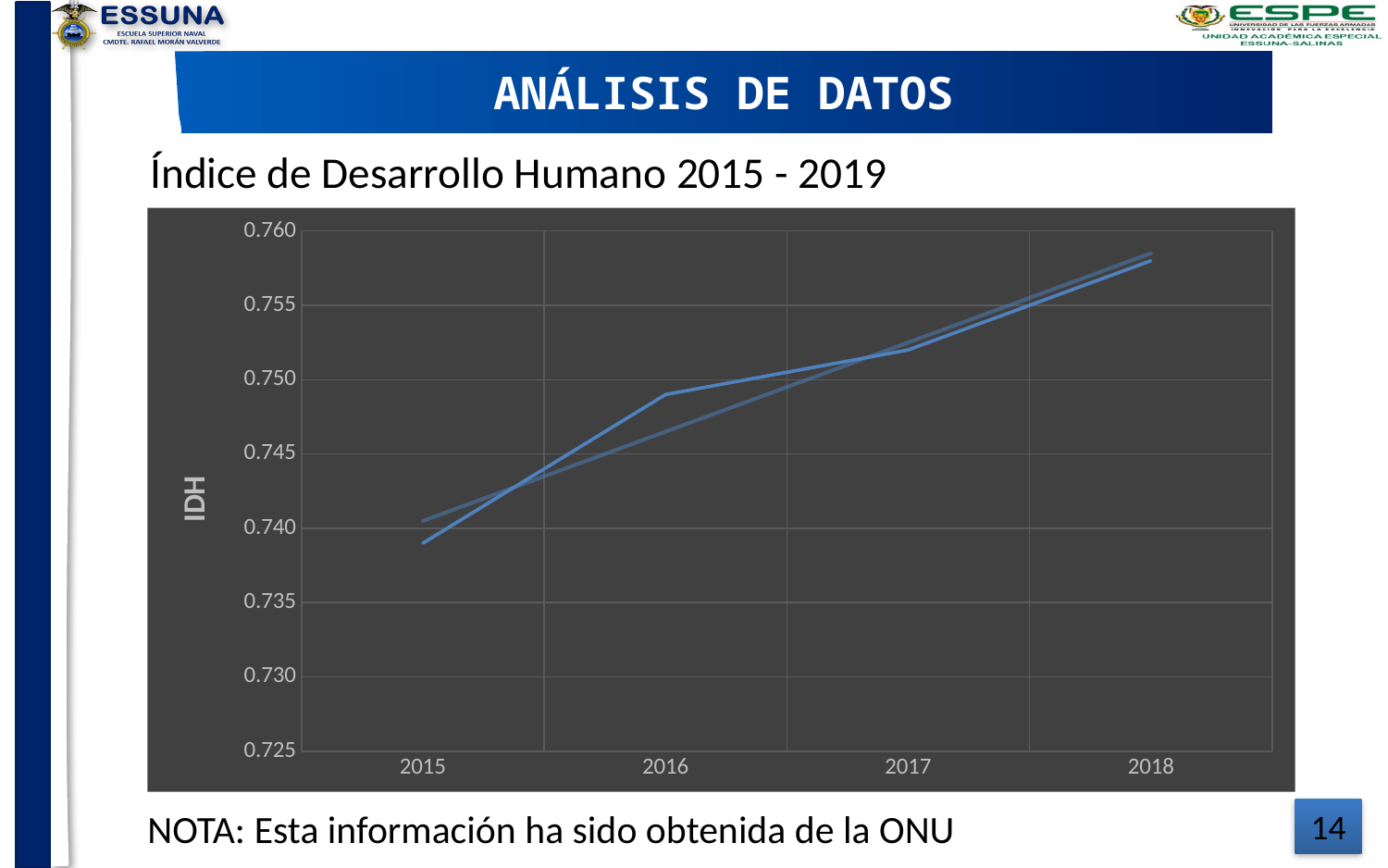
Does the IDH value rise or fall from 2015 to 2018? rise What is the title shown above the chart? Índice de Desarrollo Humano 2015 - 2019 What is the label on the vertical axis of the chart? IDH Which year has a larger IDH value, 2016 or 2017? 2017 Which year has the highest IDH value? 2018 Is the IDH value for 2017 greater or less than 0.750? greater Is the IDH value for 2018 greater or less than 0.755? greater Which year has the lowest IDH value? 2015 How many years are shown on the x axis of the chart? 4 What kind of chart is shown on the slide? line chart Is the IDH value for 2016 greater or less than 0.745? greater